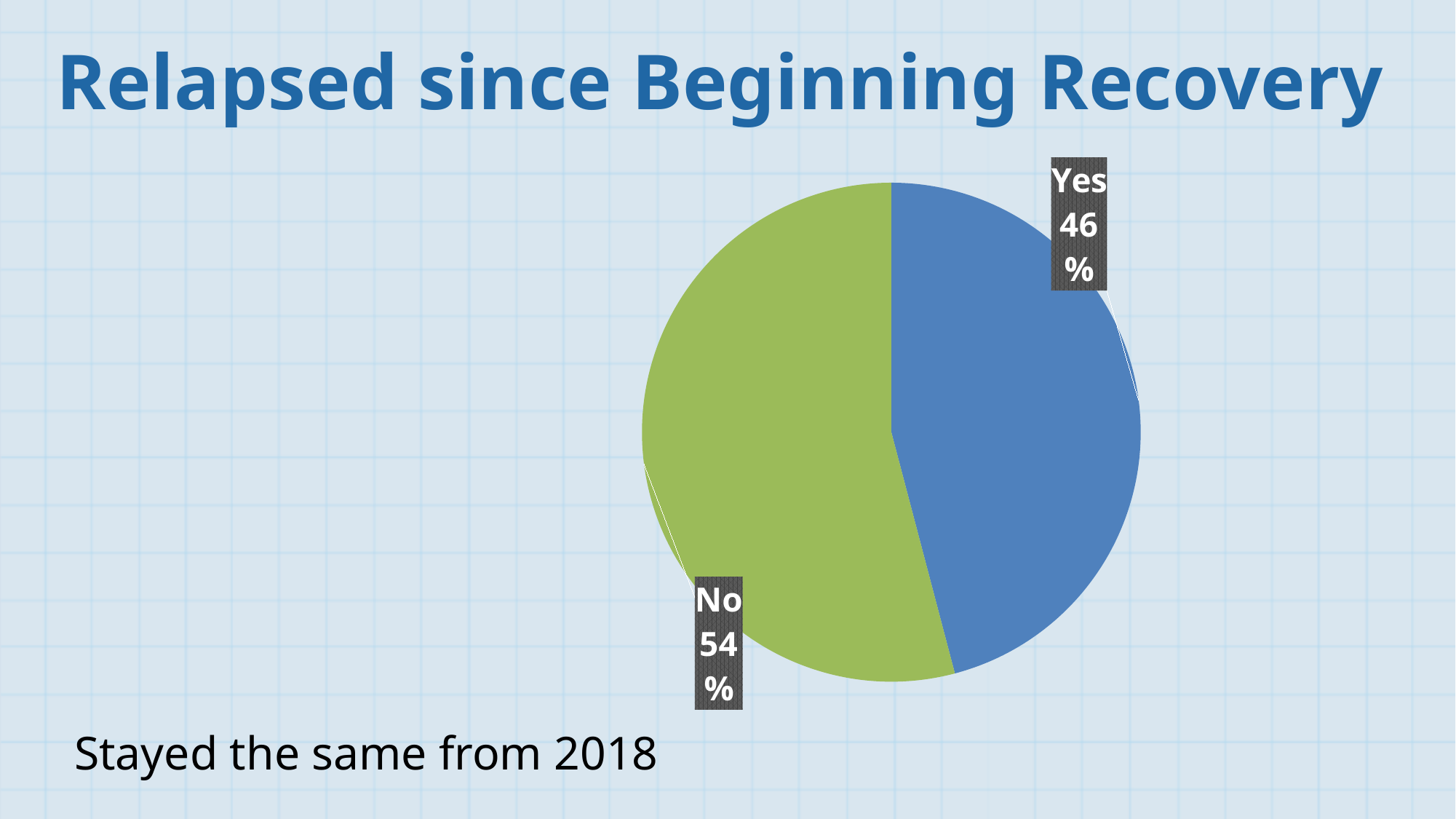
What is the title of the slide containing the chart? Relapsed since Beginning Recovery What percentage of the pie is labelled "No"? 54% What is the combined total of the "Yes" and "No" slices? 100% What percentage of the pie is labelled "Yes"? 46% Which slice is the largest? No How many slices does the pie chart have? 2 What is the difference in percentage points between the "No" slice and the "Yes" slice? 8 What kind of chart is shown on the slide? pie chart What colour is the "Yes" slice? blue Which slice is larger, "Yes" or "No"? No Is the "Yes" slice greater or less than 50%? less Which slice is the smallest? Yes